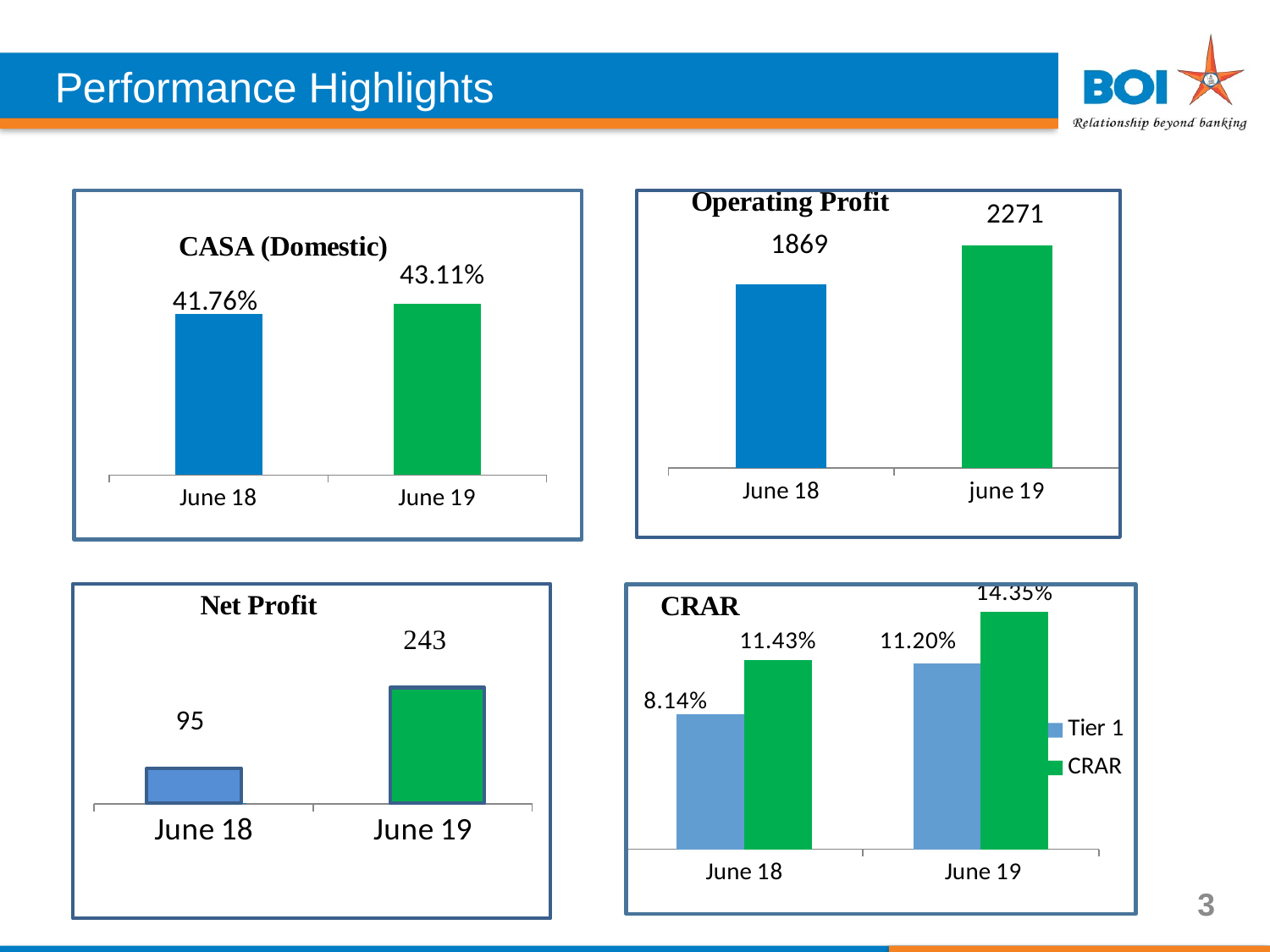
How many series does the legend of the CRAR chart list? 2 In the CRAR chart, what is the Tier 1 value for June 19? 11.20% In the CASA (Domestic) chart, which period has the higher value, June 18 or June 19? June 19 In the Net Profit chart, what is the value for June 19? 243 In the Operating Profit chart, do the values rise or fall from June 18 to June 19? rise In the Net Profit chart, what is the difference between the June 19 and June 18 values? 148 In the CRAR chart, which period has the highest CRAR value? June 19 In the CASA (Domestic) chart, what is the value for June 19? 43.11% In the CRAR chart, what is the CRAR value for June 18? 11.43% What kind of chart is the Net Profit chart? bar chart In the Operating Profit chart, what is the value for June 18? 1869 In the Operating Profit chart, what is the difference between the June 19 and June 18 values? 402